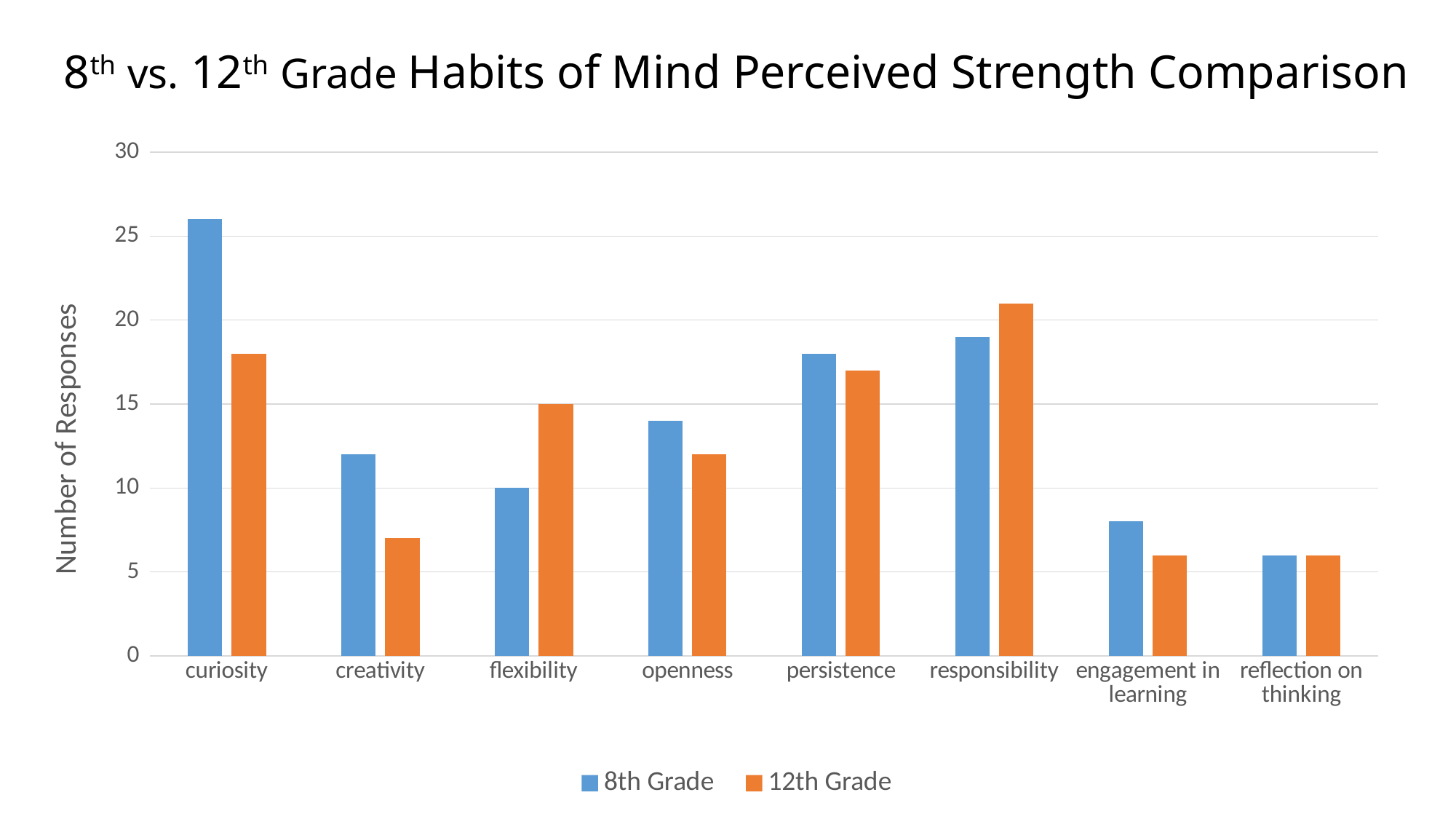
How many series does the legend list? 2 Which category has the highest 8th Grade value? curiosity How many categories are shown on the x axis? 8 Which category has the lowest 8th Grade value? reflection on thinking Which category has the highest 12th Grade value? responsibility What is the label of the y axis? Number of Responses Is the 12th Grade value for creativity greater or less than 10? less What kind of chart is shown on the slide? bar chart What is the 12th Grade value for flexibility? 15 Is the 8th Grade value for curiosity greater or less than 25? greater What is the 8th Grade value for flexibility? 10 Which is larger for openness, the 8th Grade value or the 12th Grade value? 8th Grade